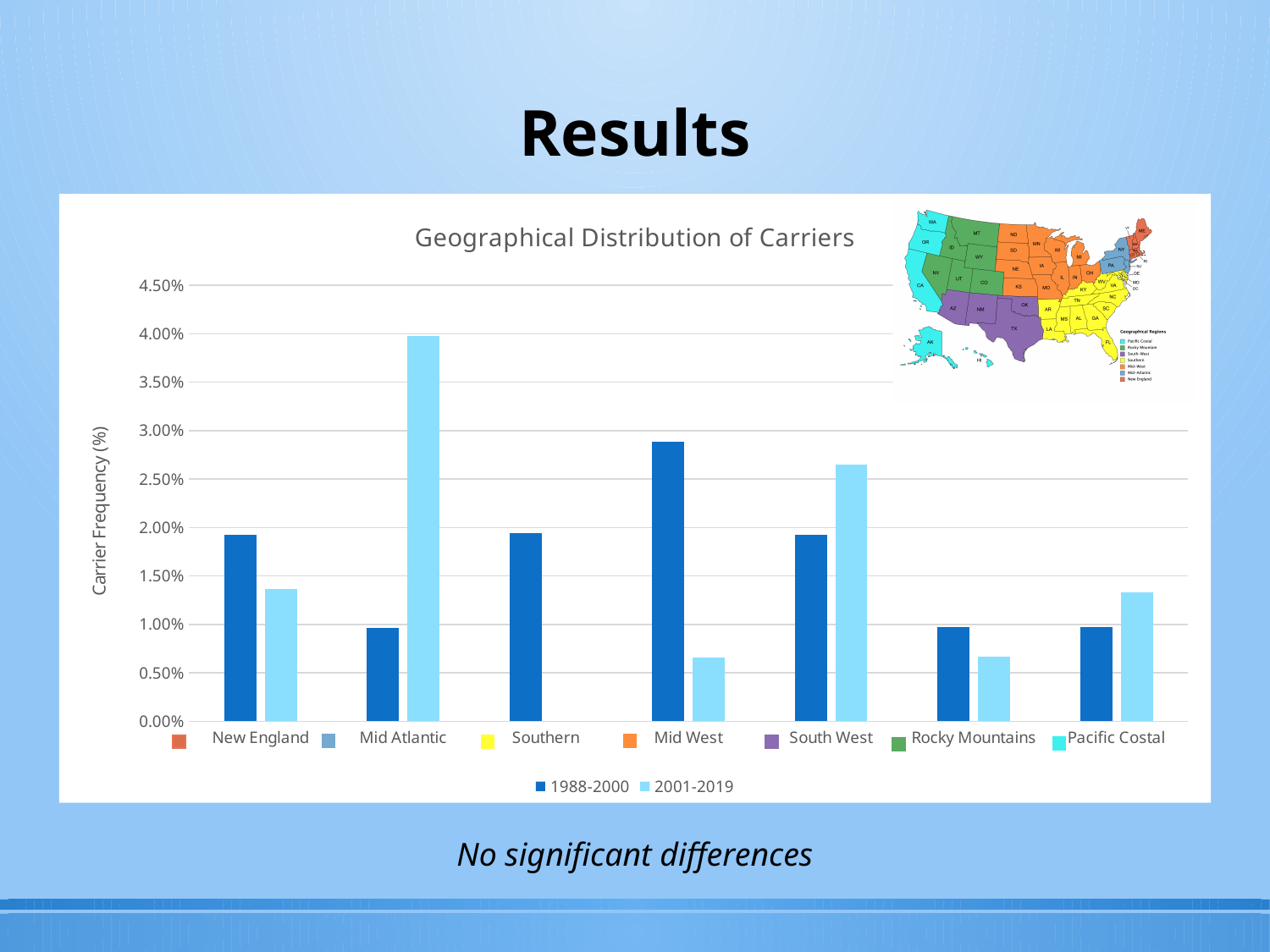
How many geographical regions are shown on the x axis? 7 How many series does the legend list? 2 Is the 1988-2000 value for Mid West greater or less than 2.50%? greater Which region has the highest value for the 2001-2019 series? Mid Atlantic For South West, which series has the larger value, 1988-2000 or 2001-2019? 2001-2019 What is the title of the chart? Geographical Distribution of Carriers Which region has the highest value for the 1988-2000 series? Mid West Is the 2001-2019 value for Mid Atlantic greater or less than 3.50%? greater What is the label of the vertical axis? Carrier Frequency (%) What type of chart is shown on the slide? Bar chart Is the 2001-2019 value for Mid West greater or less than 1.00%? less For New England, which series has the larger value, 1988-2000 or 2001-2019? 1988-2000